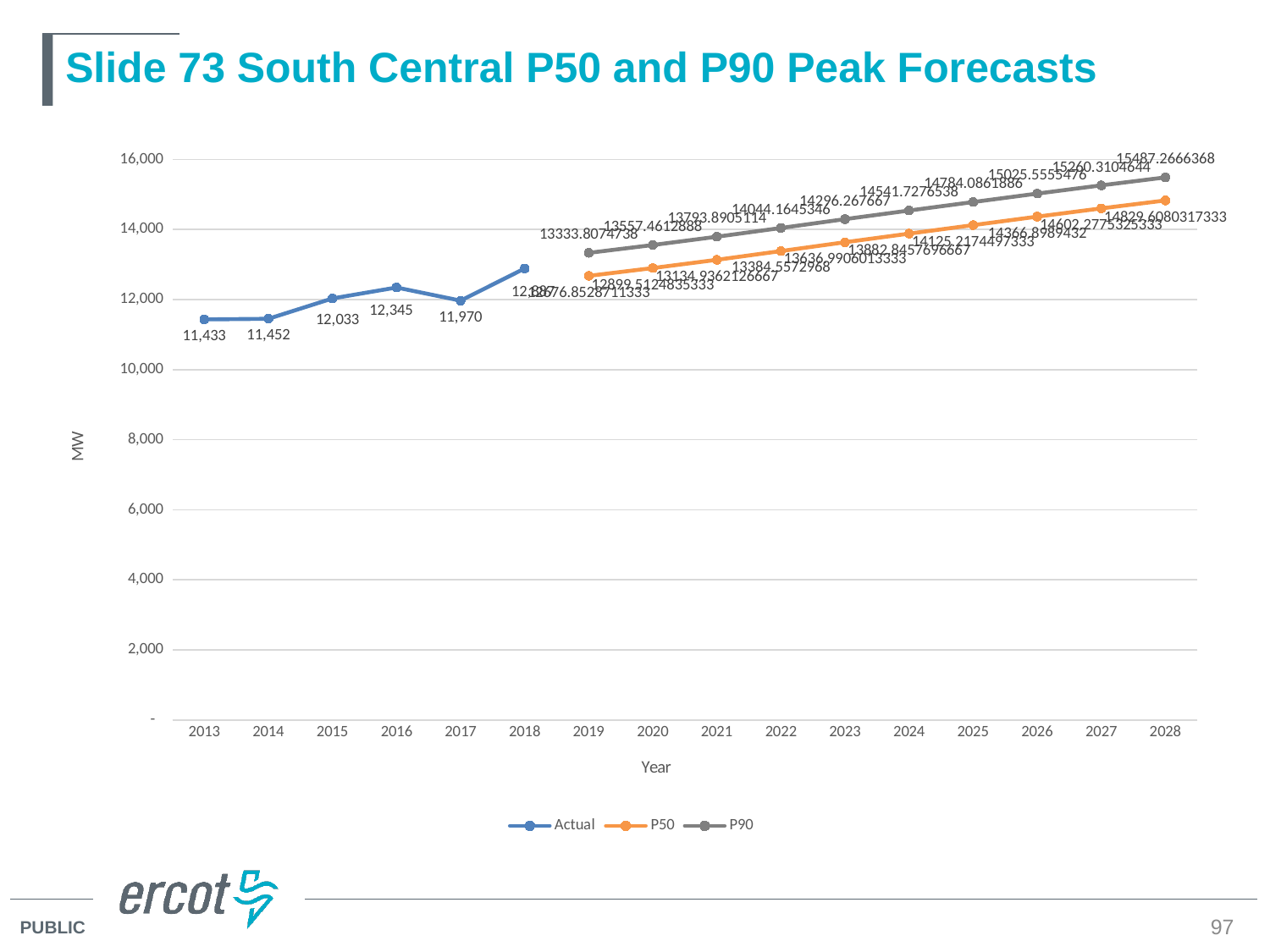
Is the P90 value for 2028 greater or less than 14,000? greater What is the Actual value for 2017? 11,970 Which is larger, the Actual value for 2014 or the Actual value for 2017? 2017 What is the Actual value for 2016? 12,345 How many series does the legend list? 3 What is the P50 forecast value for 2028? 14829.6080317333 What is the Actual value for 2013? 11,433 What is the P90 forecast value for 2028? 15487.2666368 What kind of chart is shown on the slide? line chart What is the difference between the Actual values for 2016 and 2015? 312 Does the P90 series rise or fall from 2019 to 2028? rise Which year has the lowest Actual value? 2013